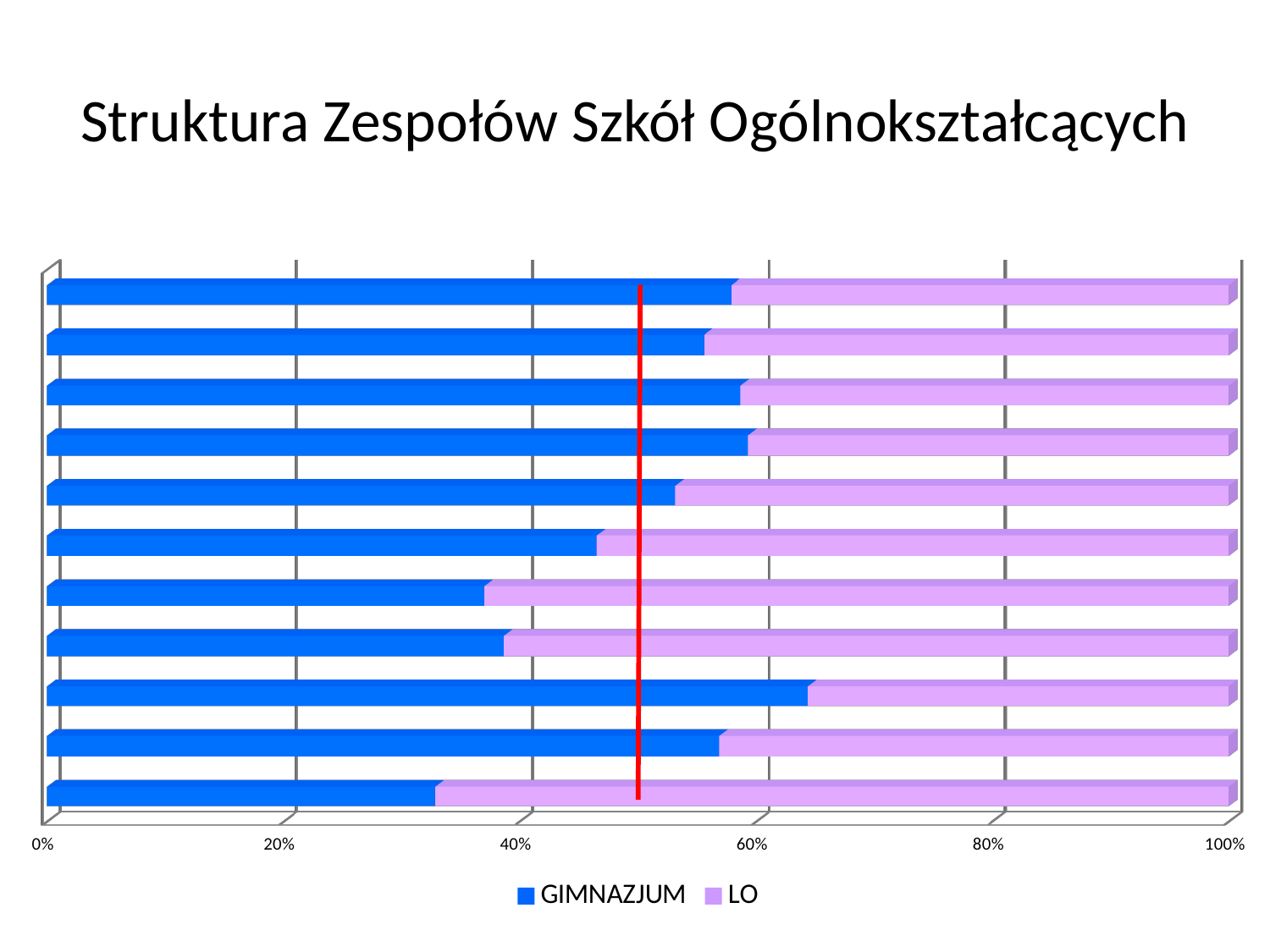
How many series does the legend list? 2 What kind of chart is shown on the slide? Stacked bar chart How many bars are plotted in the chart? 11 Which bar has the smallest GIMNAZJUM share? The bottom bar Is the GIMNAZJUM share in the third bar from the bottom greater or less than 60%? greater In the bottom bar, which series has the larger share, GIMNAZJUM or LO? LO Which bar has the largest GIMNAZJUM share? The third bar from the bottom What is the title of the chart? Struktura Zespołów Szkół Ogólnokształcących Is the GIMNAZJUM share in the top bar greater or less than 50%? greater Is the GIMNAZJUM share in the bottom bar greater or less than 40%? less What are the two series named in the legend? GIMNAZJUM and LO